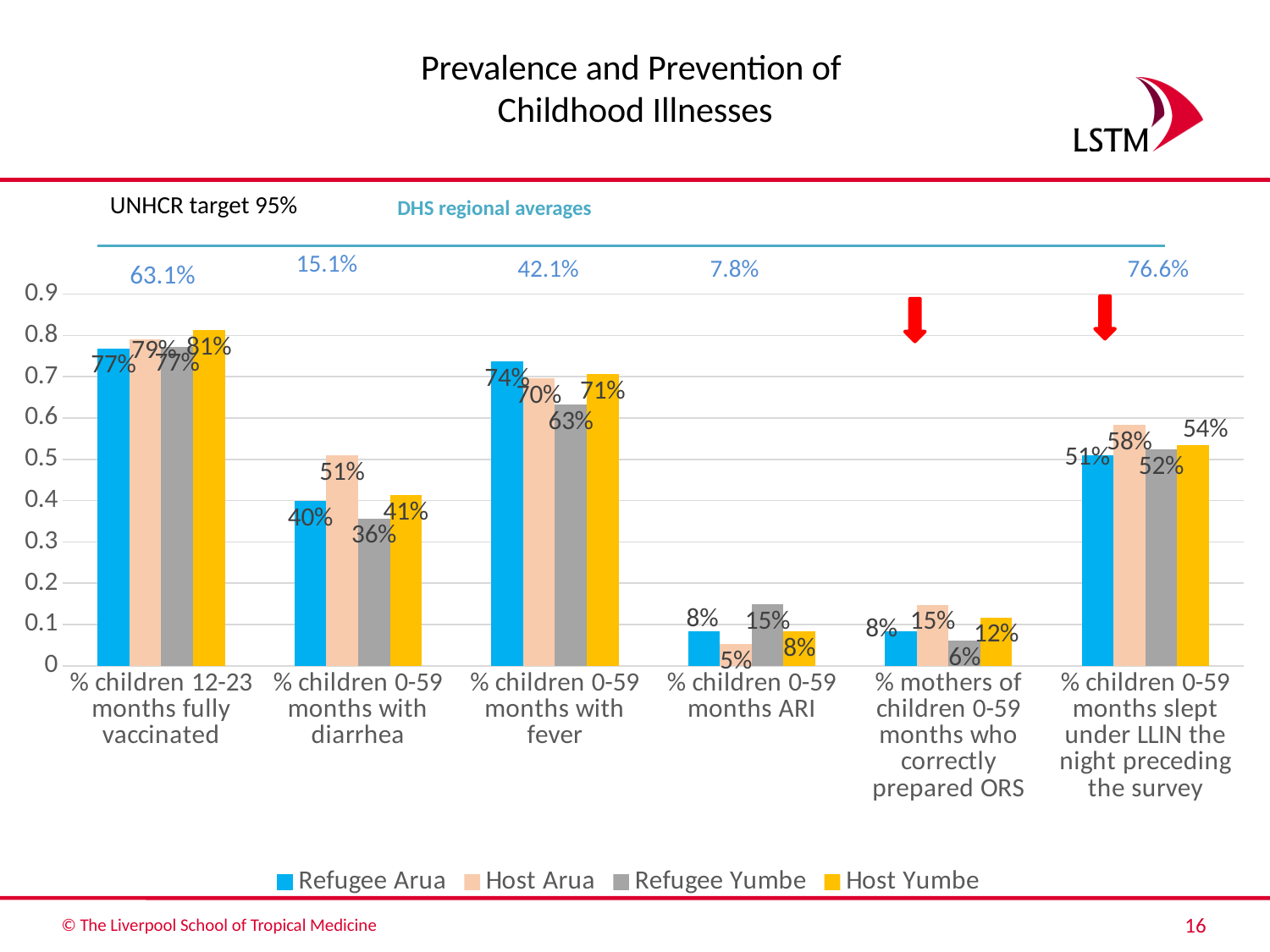
What is the difference between Host Arua and Refugee Arua in the '% children 0-59 months slept under LLIN the night preceding the survey' category? 7% What is the DHS regional average shown above the '% children 0-59 months with fever' category? 42.1% How many categories are shown on the x axis? 6 What is the value for Host Arua in the '% children 0-59 months with diarrhea' category? 51% What is the value for Refugee Yumbe in the '% children 0-59 months with fever' category? 63% What kind of chart is shown on the slide? bar chart Which is larger in the '% children 0-59 months with fever' category: Refugee Arua or Host Arua? Refugee Arua Is the value for Refugee Arua in the '% children 0-59 months with diarrhea' category greater or less than 0.5? less What is the value for Host Yumbe in the '% children 12-23 months fully vaccinated' category? 81% Which series has the highest value in the '% children 0-59 months ARI' category? Refugee Yumbe Which series has the lowest value in the '% mothers of children 0-59 months who correctly prepared ORS' category? Refugee Yumbe How many series does the legend list? 4